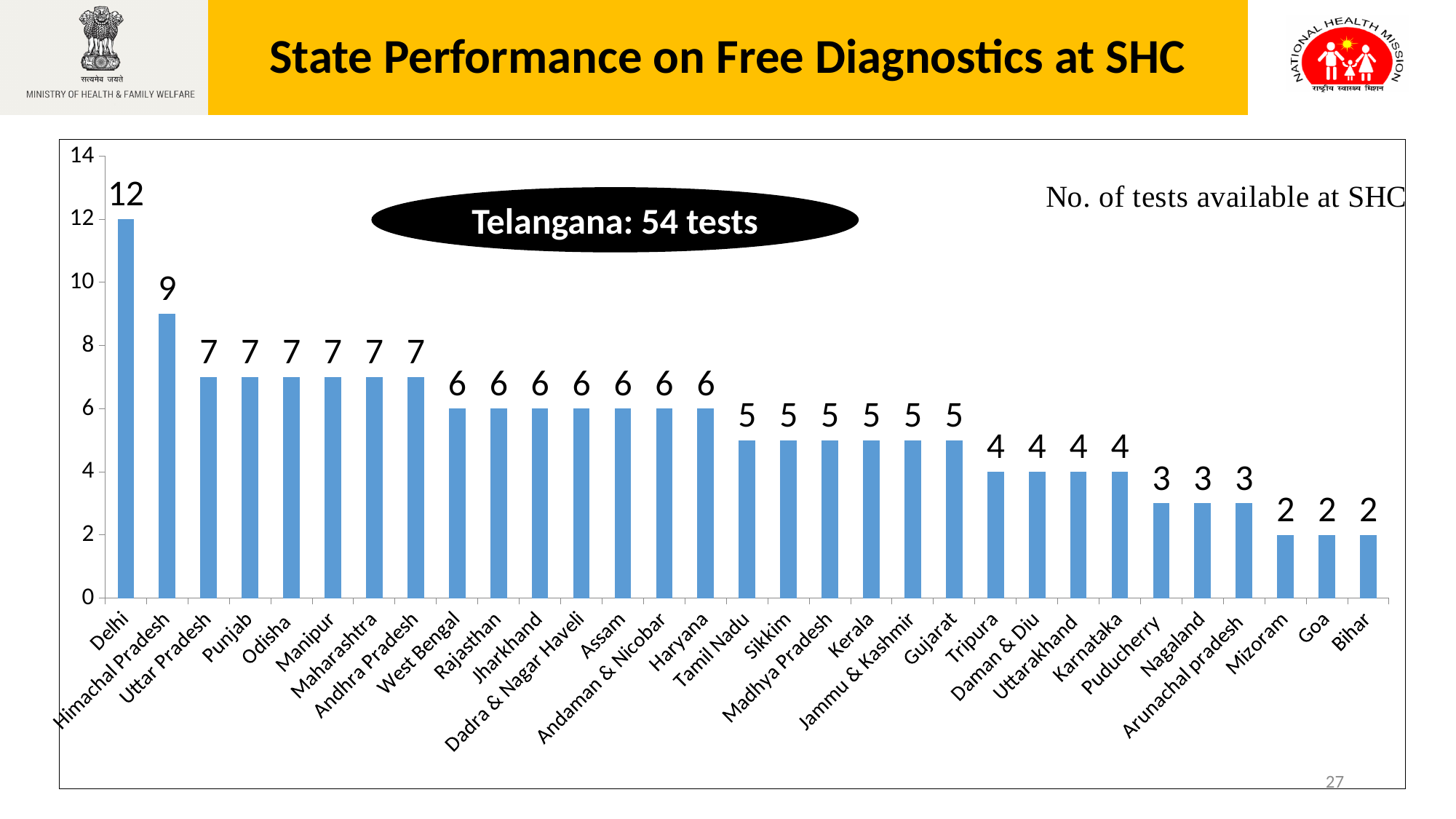
What is the value for Kerala? 5 What is the lowest value shown on the chart? 2 Which state has the highest value? Delhi According to the callout on the chart, how many tests are available in Telangana? 54 tests What is the value for Himachal Pradesh? 9 What is the value for Karnataka? 4 What is the value for Delhi? 12 What is the value for Bihar? 2 What is the difference between the values for Delhi and Himachal Pradesh? 3 What kind of chart is shown on the slide? Bar chart Which has a larger value, Punjab or Gujarat? Punjab How many states or territories are shown on the chart? 31